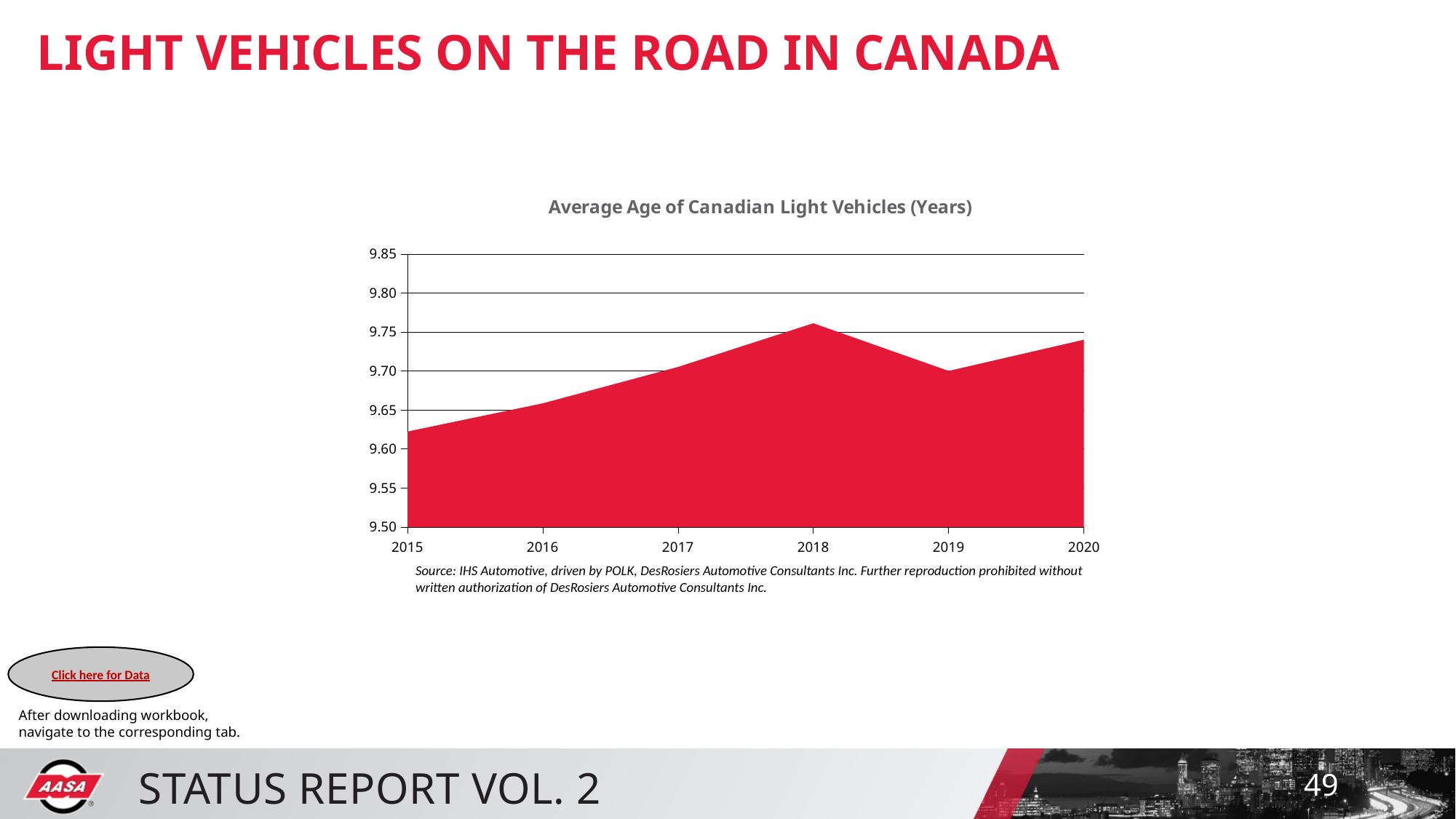
What type of chart is shown on the slide? Area chart Is the value for 2015 greater or less than 9.65? less Is the value for 2018 greater or less than 9.70? greater Is the value for 2019 greater or less than 9.75? less Does the average age of Canadian light vehicles rise or fall from 2015 to 2018? Rise What is the title of the chart? Average Age of Canadian Light Vehicles (Years) Which year has the highest average age of Canadian light vehicles? 2018 Which year has the lowest average age of Canadian light vehicles? 2015 How many years are plotted on the x axis of the chart? 6 Which year has a higher average vehicle age, 2018 or 2019? 2018